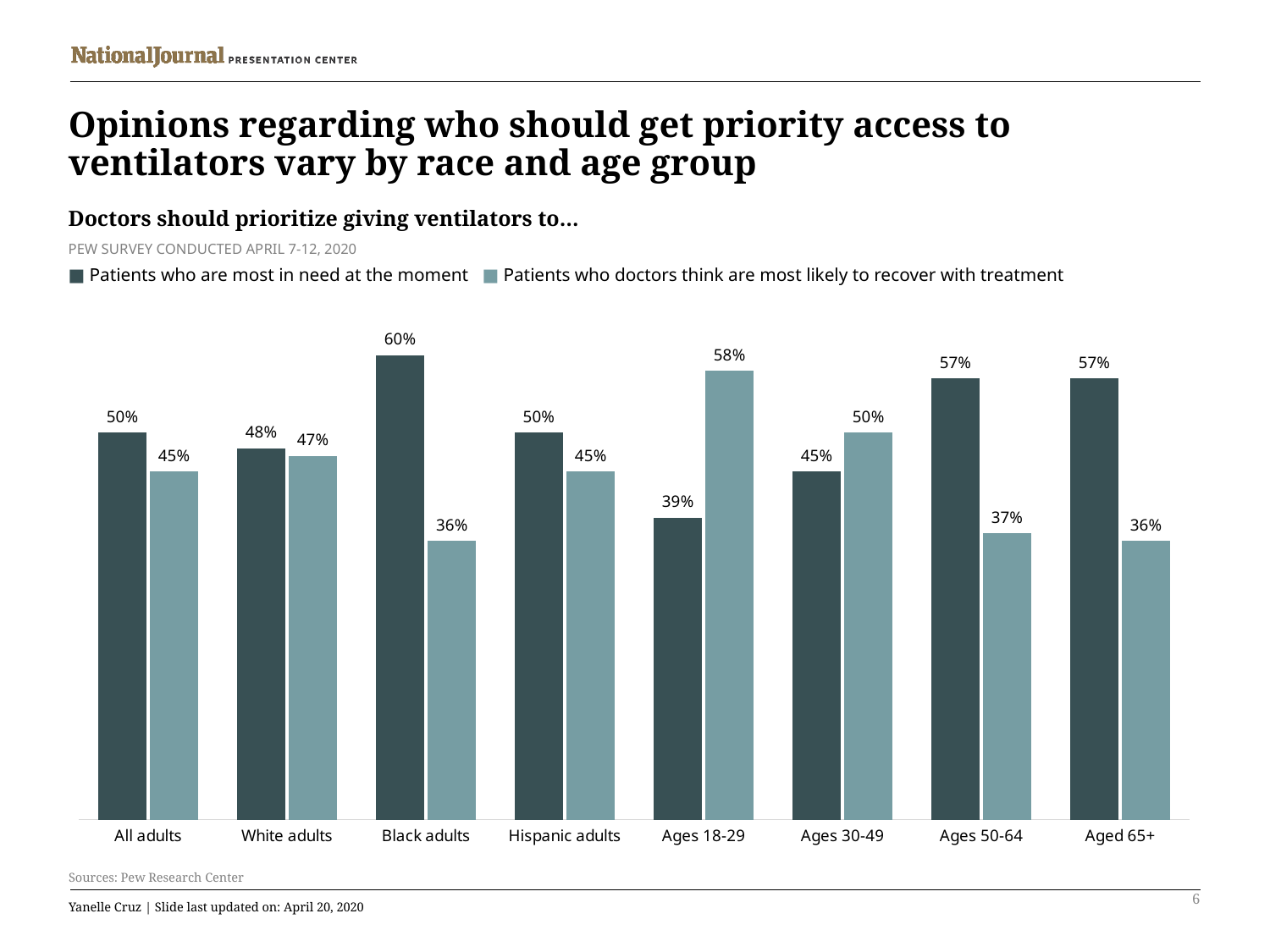
How many series does the legend list? 2 What percentage of Black adults say doctors should prioritize patients who are most in need at the moment? 60% Which group has the highest value for 'Patients who are most in need at the moment'? Black adults For Ages 30-49, which series has the larger value? Patients who doctors think are most likely to recover with treatment How many groups are shown on the x axis? 8 Across the age groups from Ages 18-29 to Aged 65+, does the 'Patients who are most in need at the moment' value rise or fall? Rise What is the value for White adults in the 'Patients who doctors think are most likely to recover with treatment' series? 47% When was the Pew survey shown in the chart conducted? April 7-12, 2020 What kind of chart is shown on the slide? Bar chart Which group has the lowest value for 'Patients who are most in need at the moment'? Ages 18-29 What percentage of adults aged 18-29 say doctors should prioritize patients most likely to recover with treatment? 58% What is the difference between the two series for Black adults? 24 percentage points